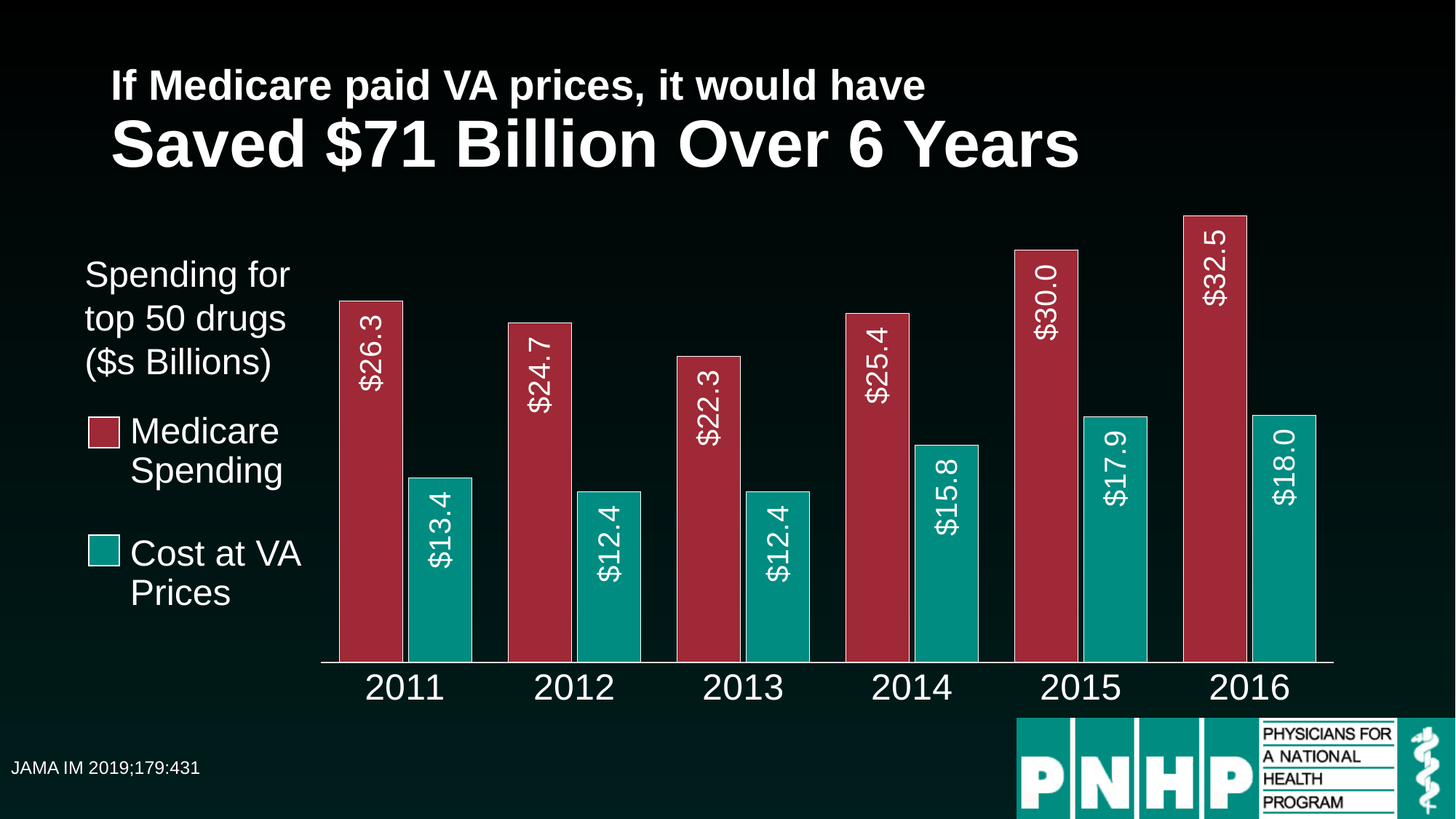
Does the Cost at VA Prices rise or fall from 2013 to 2016? Rise What colour are the bars for Cost at VA Prices? Teal What is the difference between Medicare Spending and Cost at VA Prices in 2016? $14.5 What is the difference between Medicare Spending in 2015 and 2014? $4.6 How many years are shown on the x axis? 6 In which year was Medicare Spending highest? 2016 In which year was Medicare Spending lowest? 2013 What was the Cost at VA Prices in 2015? $17.9 How many series does the legend list? 2 What was Medicare Spending in 2014? $25.4 Which is larger: Medicare Spending in 2011 or Medicare Spending in 2012? Medicare Spending in 2011 What kind of chart is shown on the slide? Bar chart